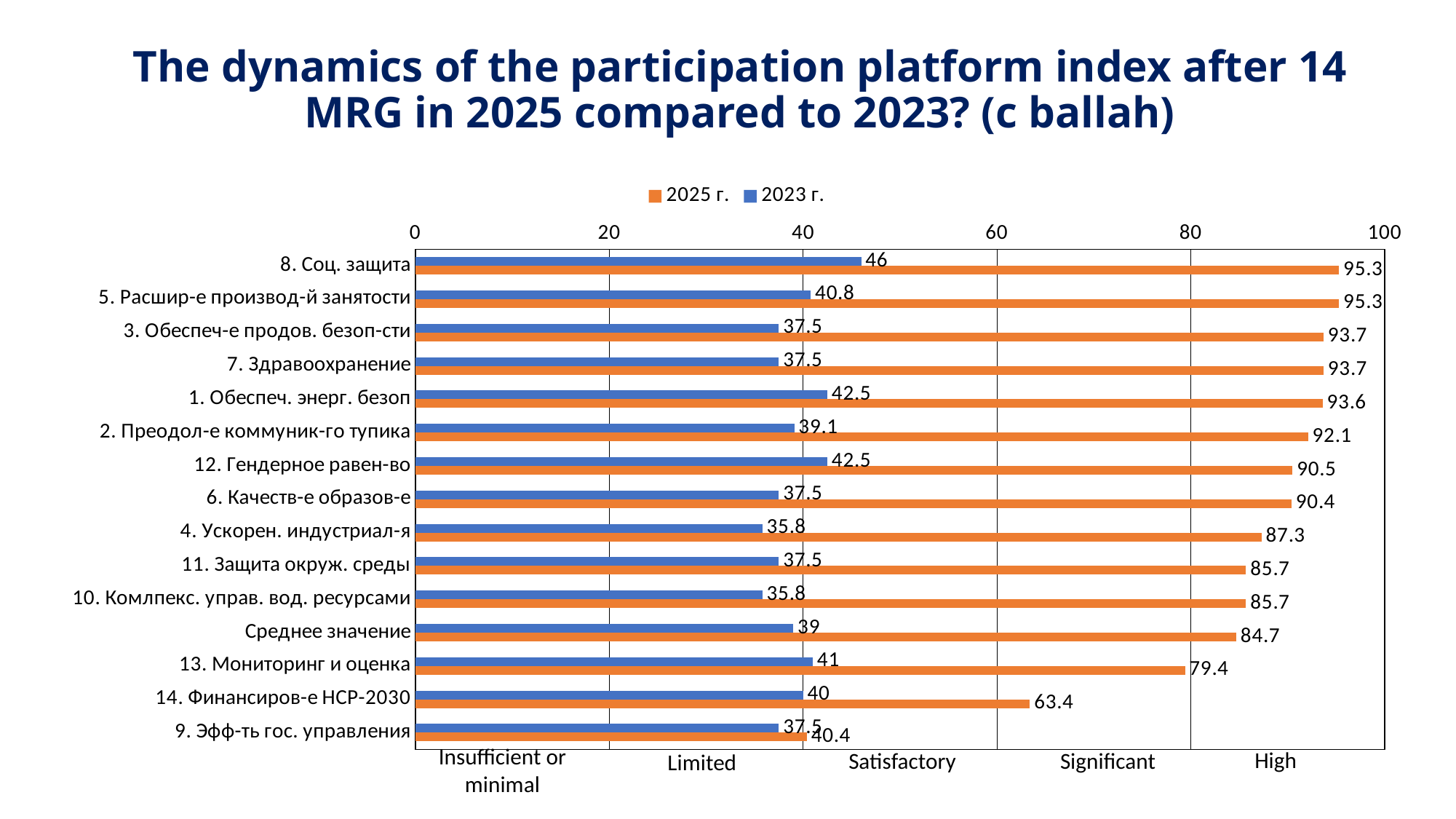
Which is larger: the 2025 г. value for 4. Ускорен. индустриал-я or for 12. Гендерное равен-во? 12. Гендерное равен-во What is the 2025 г. value for 8. Соц. защита? 95.3 What is the 2023 г. value for 1. Обеспеч. энерг. безоп? 42.5 What is the difference between the 2025 г. values for 14. Финансиров-е НСР-2030 and 9. Эфф-ть гос. управления? 23 How many categories are shown on the chart? 15 Which category has the lowest 2025 г. value? 9. Эфф-ть гос. управления What kind of chart is shown on the slide? Bar chart Which category has the highest 2023 г. value? 8. Соц. защита What is the 2025 г. value for Среднее значение? 84.7 What is the difference between the 2025 г. and 2023 г. values for 13. Мониторинг и оценка? 38.4 What is the 2023 г. value for 14. Финансиров-е НСР-2030? 40 How many series does the legend list? 2